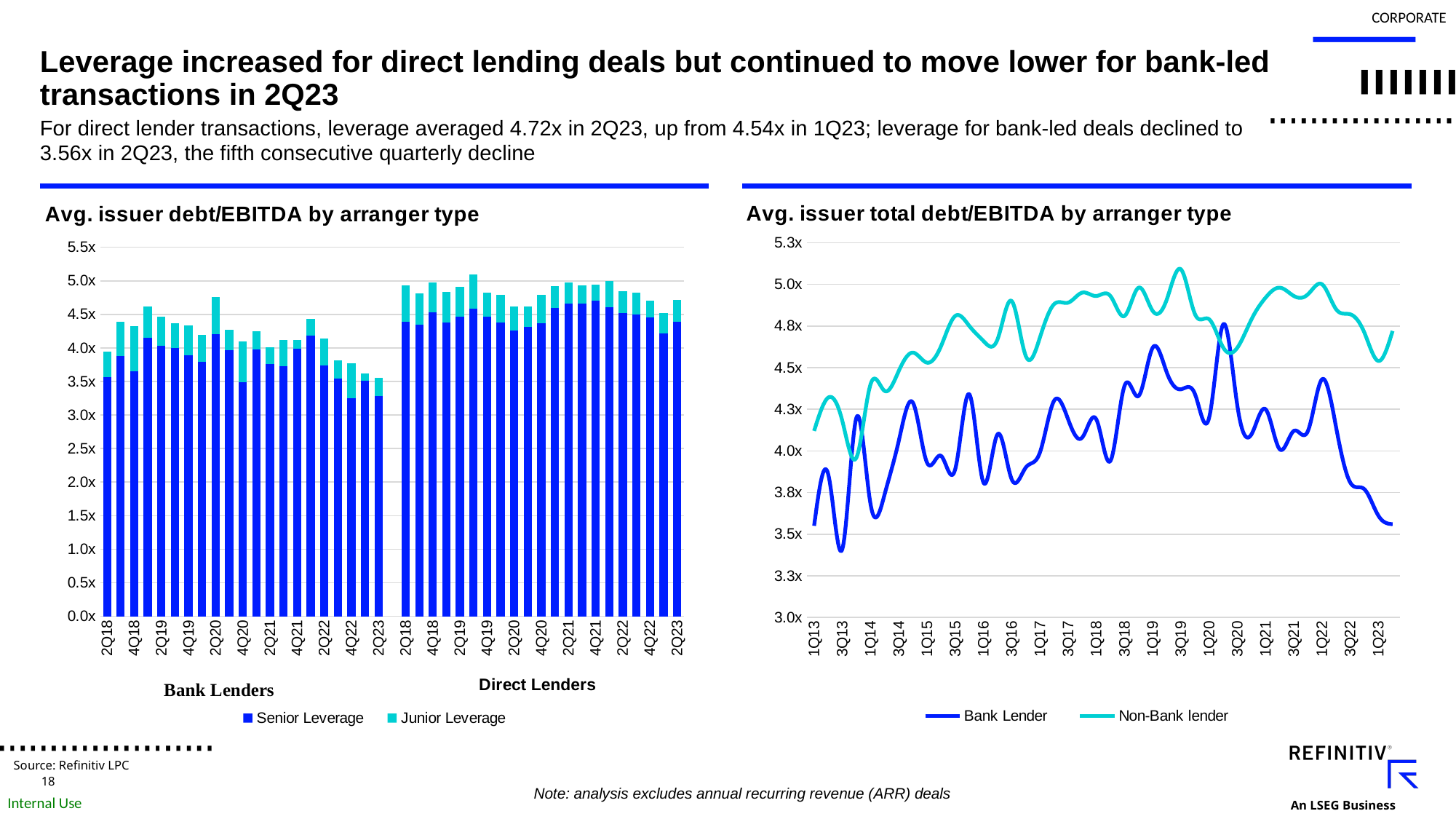
How many series does the legend of the left chart, "Avg. issuer debt/EBITDA by arranger type", list? 2 How many series does the legend of the right chart, "Avg. issuer total debt/EBITDA by arranger type", list? 2 In the right chart, "Avg. issuer total debt/EBITDA by arranger type", is the Bank Lender value at 1Q23 greater or less than 4.0x? less What kind of chart is "Avg. issuer debt/EBITDA by arranger type" on the left of the slide? Stacked bar chart In the left chart, "Avg. issuer debt/EBITDA by arranger type", is the total bar for Bank Lenders in 2Q20 greater or less than 4.5x? greater In the left chart, "Avg. issuer debt/EBITDA by arranger type", is the total bar for Bank Lenders in 2Q23 greater or less than 4.0x? less In the right chart, "Avg. issuer total debt/EBITDA by arranger type", which series is higher at 1Q23, Bank Lender or Non-Bank lender? Non-Bank lender In the right chart, "Avg. issuer total debt/EBITDA by arranger type", does the Bank Lender line rise or fall from 1Q22 to 1Q23? Fall In the left chart, "Avg. issuer debt/EBITDA by arranger type", which legend entry is shown in the lighter teal colour? Junior Leverage What kind of chart is "Avg. issuer total debt/EBITDA by arranger type" on the right of the slide? Line chart